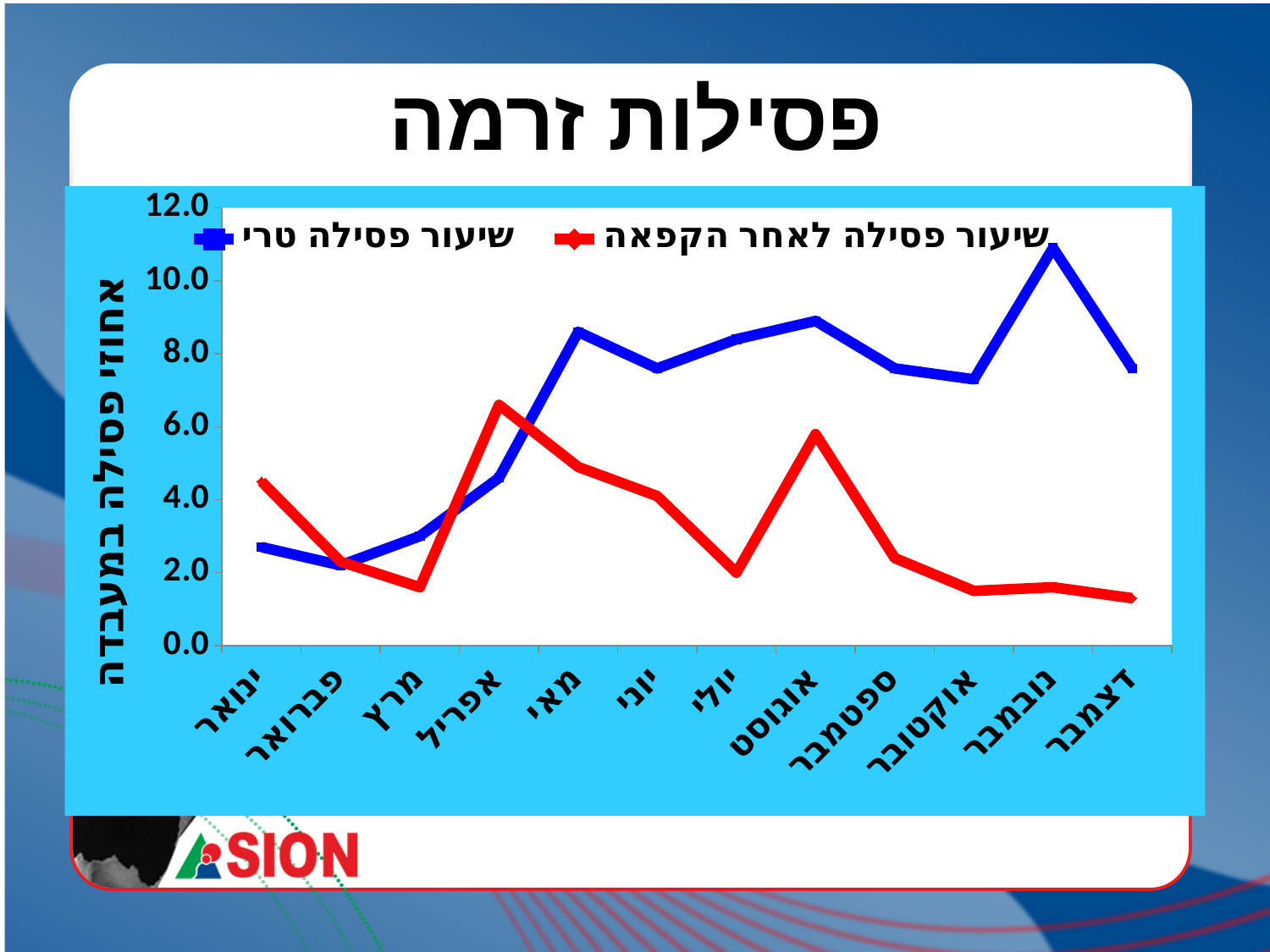
In which month does the series שיעור פסילה טרי reach its highest value? נובמבר In אוגוסט, which series has the higher value, שיעור פסילה טרי or שיעור פסילה לאחר הקפאה? שיעור פסילה טרי In אפריל, which series has the higher value, שיעור פסילה טרי or שיעור פסילה לאחר הקפאה? שיעור פסילה לאחר הקפאה Is the value of שיעור פסילה טרי in נובמבר greater or less than 10.0? greater In which month does the series שיעור פסילה לאחר הקפאה reach its highest value? אפריל Is the value of שיעור פסילה לאחר הקפאה in אפריל greater or less than 6.0? greater Is the value of שיעור פסילה לאחר הקפאה in מרץ greater or less than 2.0? less How many series does the legend list? 2 What is the title of the chart? פסילות זרמה What kind of chart is shown on the slide? line chart How many months are plotted along the x axis? 12